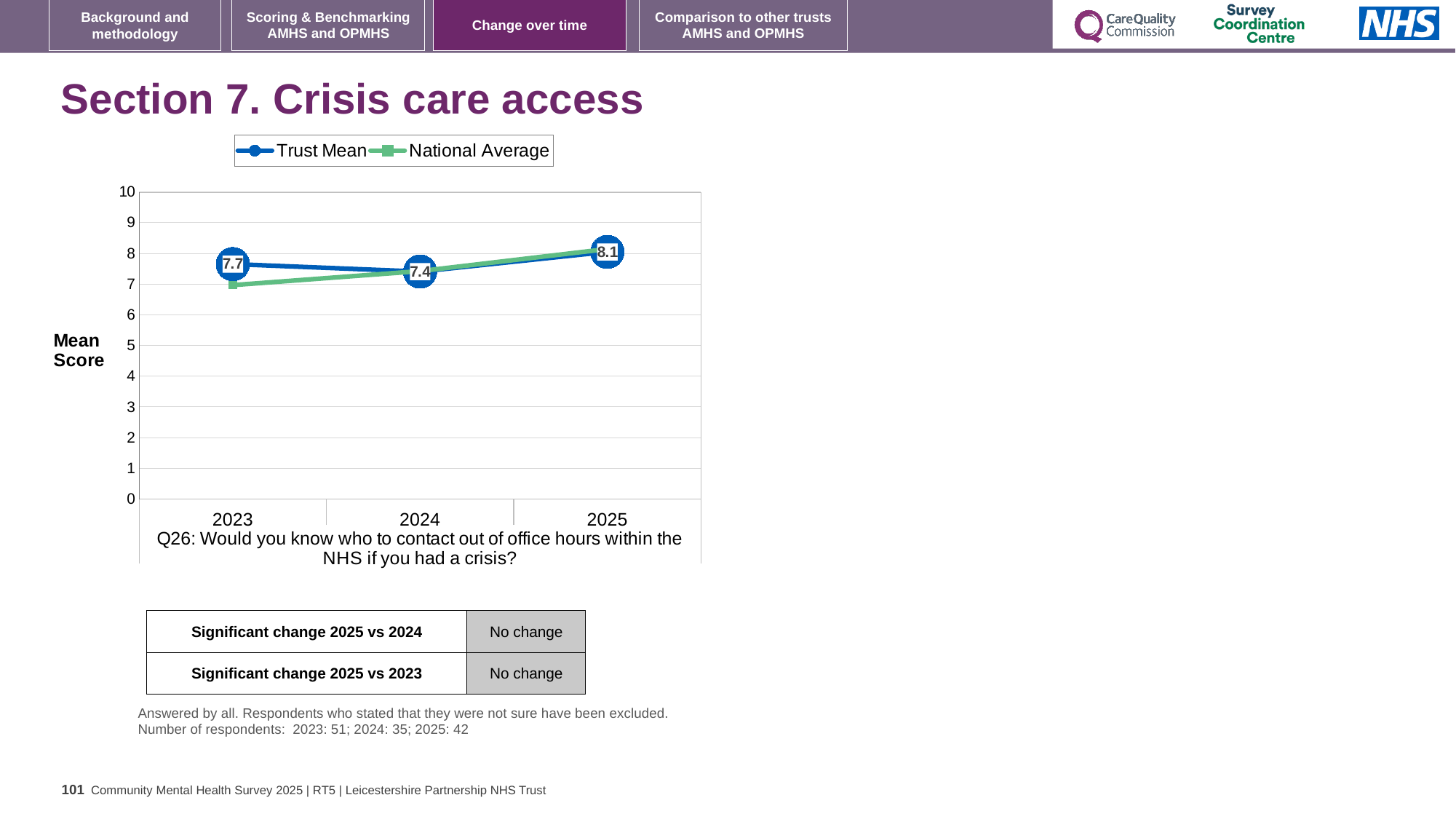
What is the Trust Mean value for 2023? 7.7 Does the National Average rise or fall from 2023 to 2025? rise What is the Trust Mean value for 2024? 7.4 In which year is the Trust Mean highest? 2025 What kind of chart is shown on the slide? line chart How many years are plotted on the x axis? 3 Which is larger, the Trust Mean in 2023 or in 2024? 2023 Is the National Average value for 2023 greater or less than 6? greater How many series does the legend list? 2 What is the difference between the Trust Mean in 2025 and in 2024? 0.7 What is the Trust Mean value for 2025? 8.1 In which year is the Trust Mean lowest? 2024